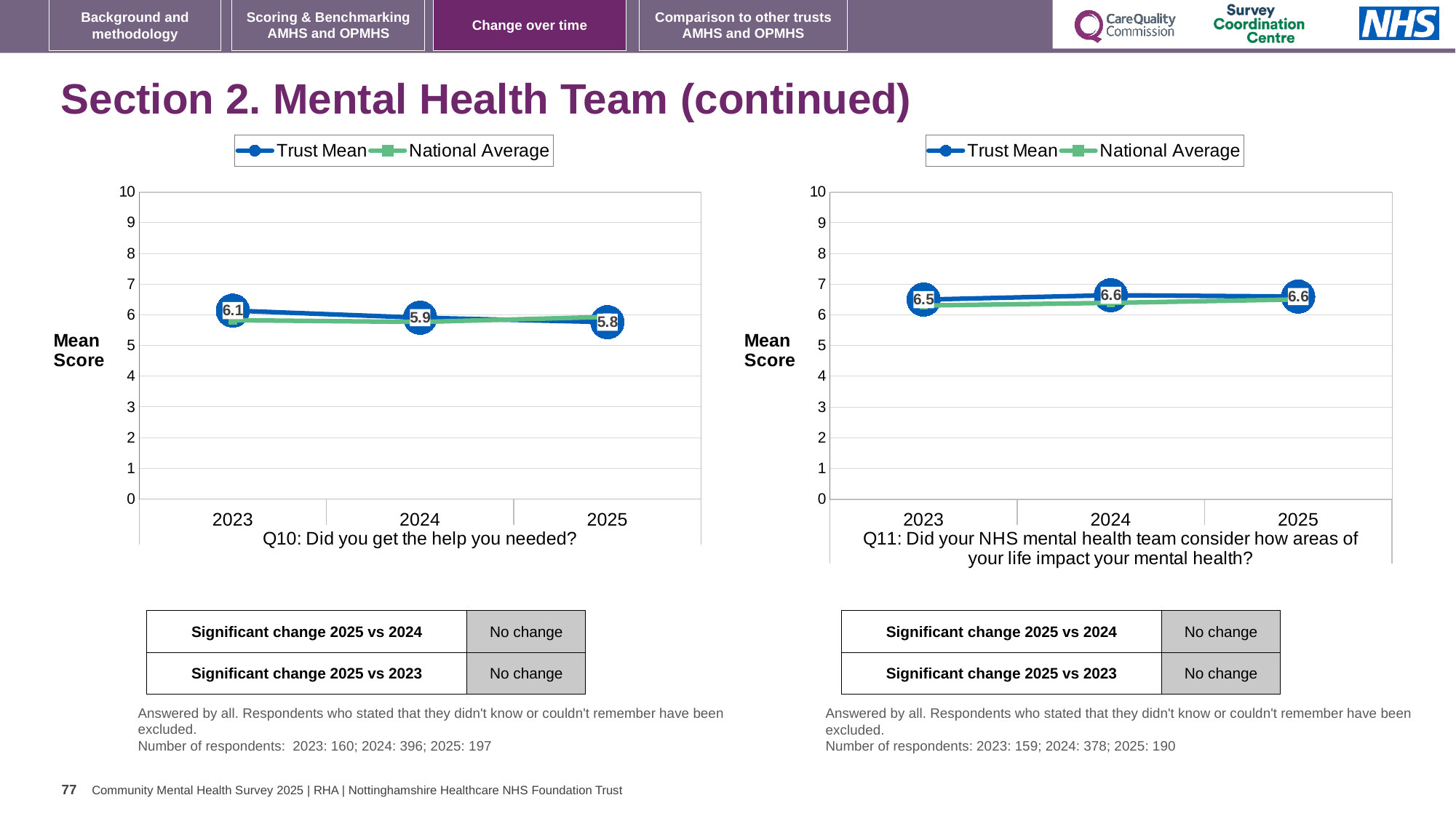
In the Q10 chart, is the National Average value for 2023 greater or less than 5? greater In the Q11 chart, which year has the lowest Trust Mean score? 2023 In the Q10 chart, what is the difference between the Trust Mean scores for 2023 and 2025? 0.3 In the Q10 chart, what is the Trust Mean score for 2023? 6.1 Is the Trust Mean score for 2025 higher in the Q10 chart or the Q11 chart? Q11 chart In the Q11 chart, what is the Trust Mean score for 2024? 6.6 What kind of chart is the Q10 chart? Line chart In the Q11 chart, what is the Trust Mean score for 2023? 6.5 How many years are shown on the x axis of the Q11 chart? 3 How many series does the legend of the Q10 chart list? 2 In the Q10 chart, which year has the highest Trust Mean score? 2023 In the Q10 chart, what is the Trust Mean score for 2025? 5.8